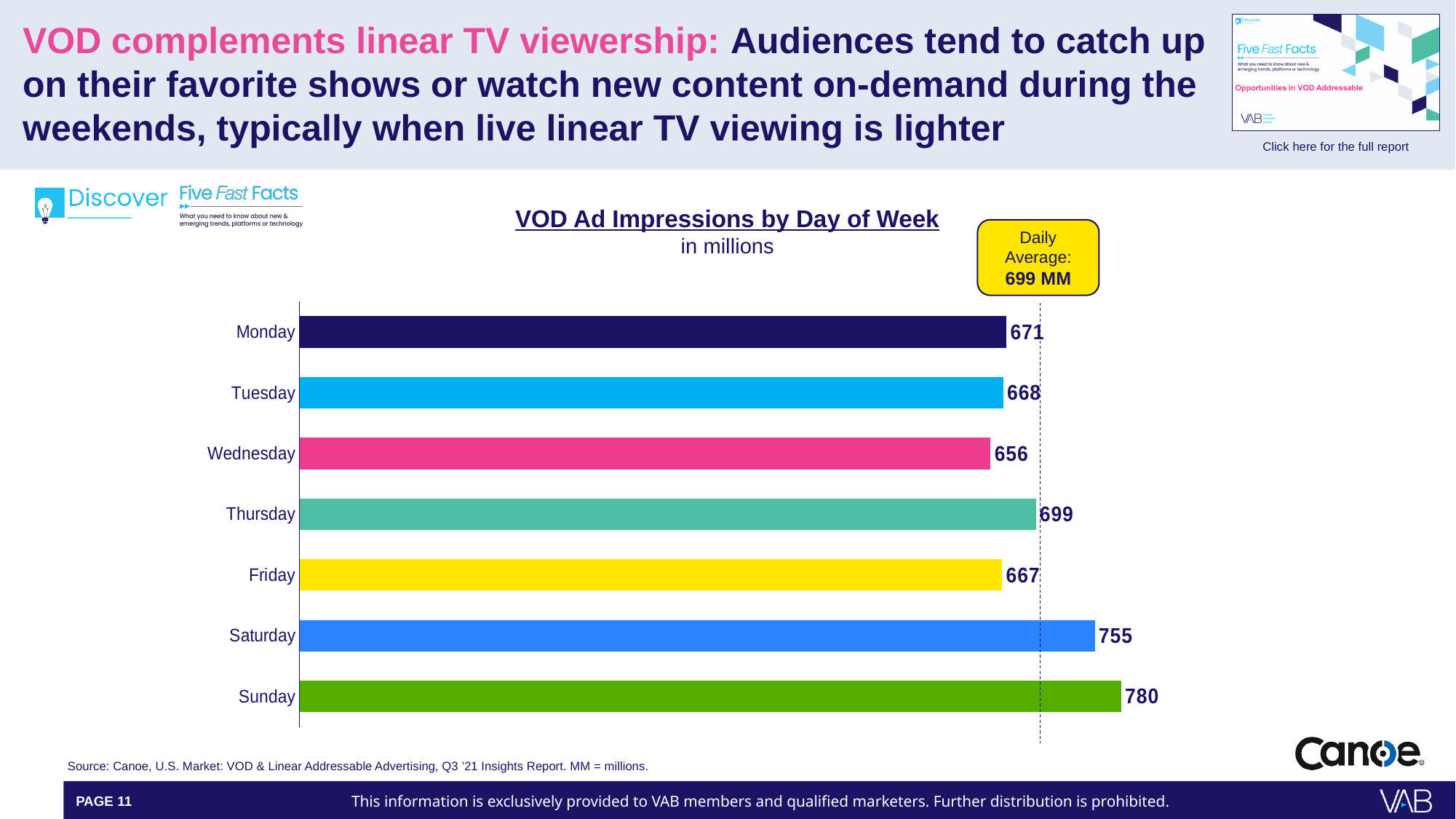
In what units are the VOD ad impressions shown, according to the chart subtitle? in millions What is the difference between Monday's and Wednesday's VOD ad impressions? 15 Which day has the lowest VOD ad impressions? Wednesday What is the value for Wednesday in the VOD Ad Impressions by Day of Week chart? 656 What daily average is shown in the callout box next to the chart? 699 MM What is the value for Thursday in the VOD Ad Impressions by Day of Week chart? 699 What is the difference between Sunday's and Saturday's VOD ad impressions? 25 Which has more VOD ad impressions, Thursday or Friday? Thursday What kind of chart is used to show VOD Ad Impressions by Day of Week? Bar chart What is the value for Sunday in the VOD Ad Impressions by Day of Week chart? 780 Which day has the highest VOD ad impressions? Sunday How many days of the week are shown in the chart? 7